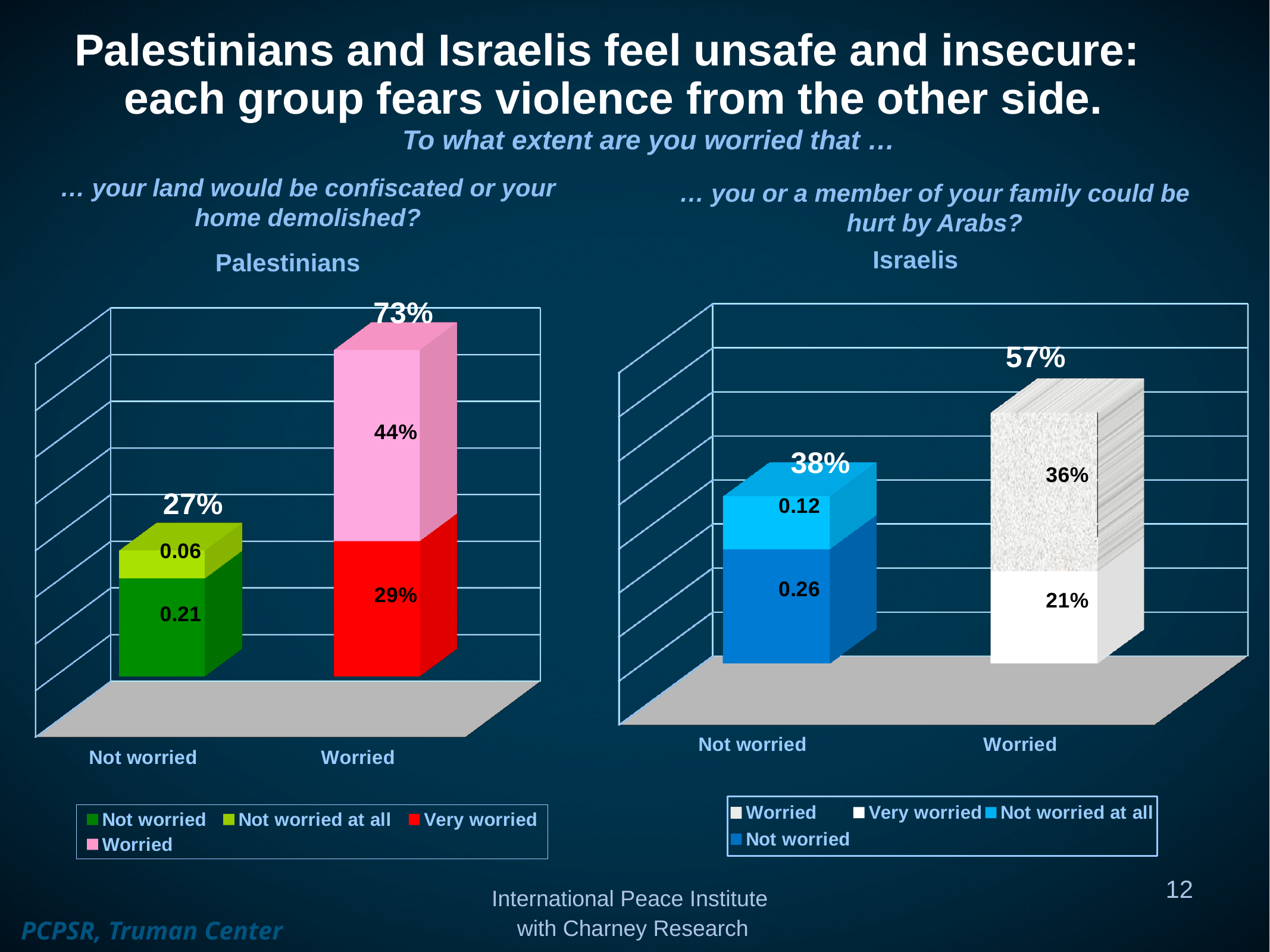
In the Palestinians chart, what is the total shown above the Worried bar? 73% In the Palestinians chart, what is the difference between the Worried segment (44%) and the Very worried segment (29%)? 15% In the Palestinians chart, what is the total shown above the Not worried bar? 27% In the Palestinians chart, what value is labelled on the Not worried at all segment? 0.06 In the Israelis chart, what value is labelled on the Very worried segment? 21% What kind of chart is the Palestinians chart? Stacked bar chart In the Israelis chart, what is the total shown above the Worried bar? 57% In the Israelis chart, which bar is taller, Not worried or Worried? Worried In the Israelis chart, what value is labelled on the Not worried segment of the Not worried bar? 0.26 In the Palestinians chart, what value is labelled on the Very worried segment of the Worried bar? 29% How many series does the legend of the Israelis chart list? 4 In the Palestinians chart, what colour is the Very worried segment? Red